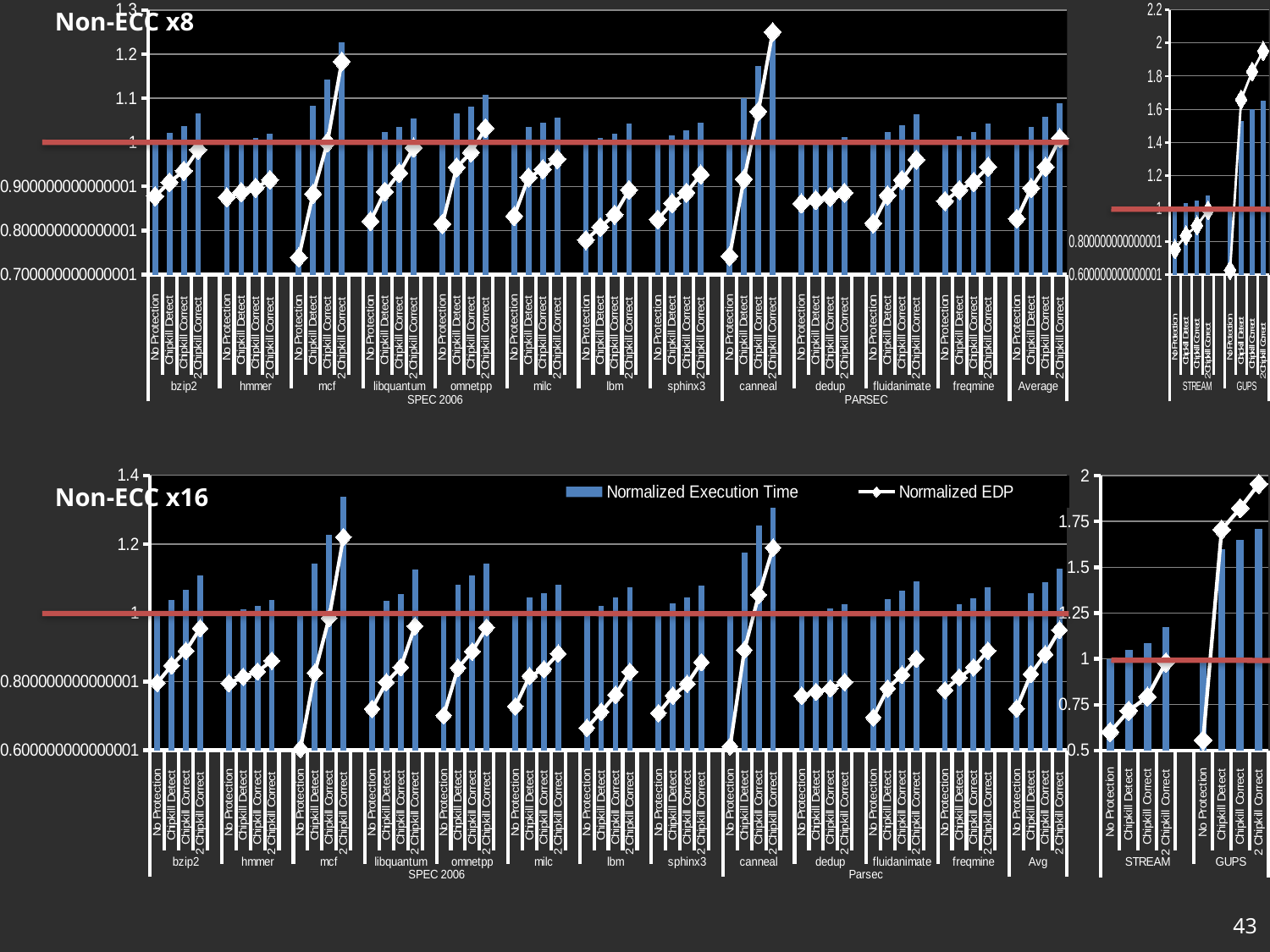
In the Non-ECC x8 chart, how many benchmark categories are shown along the x axis (including Average)? 13 What are the two series named in the legend of the Non-ECC x16 chart? Normalized Execution Time and Normalized EDP How many series does the legend on the Non-ECC x16 chart list? 2 In the bottom-right chart (STREAM and GUPS), how many bars are plotted in total? 8 In the bottom-right chart (STREAM and GUPS), is the Normalized EDP for GUPS with 2 Chipkill Correct greater or less than 1.75? greater In the Non-ECC x8 chart, is the Normalized EDP for bzip2 with No Protection greater or less than 1? less In the Non-ECC x16 chart, does the Normalized EDP for mcf rise or fall going from No Protection to 2 Chipkill Correct? rise In the Non-ECC x8 chart, which benchmark has the highest Normalized EDP at the 2 Chipkill Correct configuration? canneal In the Non-ECC x8 chart, is the Normalized EDP for canneal with 2 Chipkill Correct greater or less than 1.2? greater What kind of chart is the Non-ECC x8 chart? A combined bar and line chart